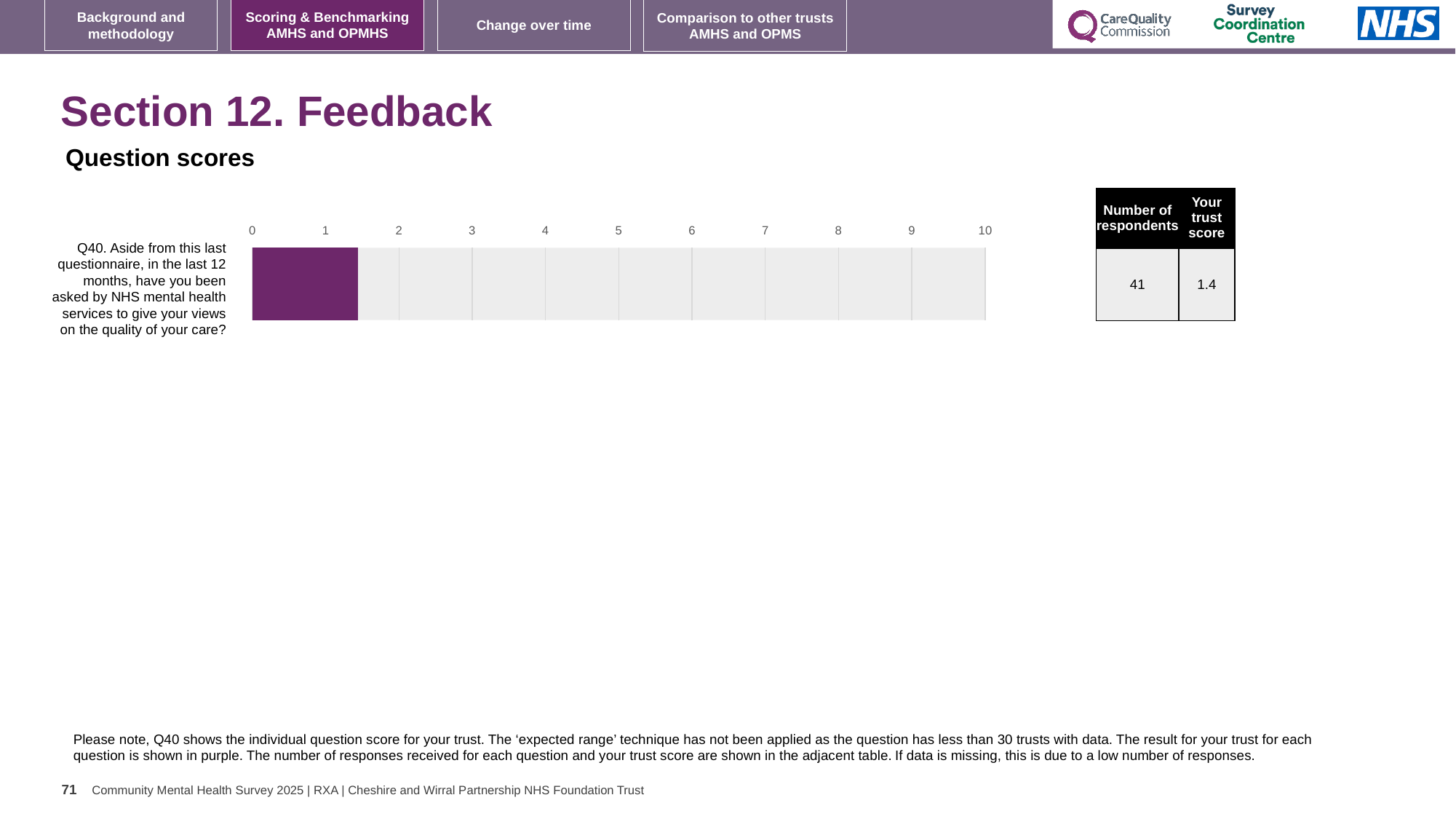
Is the bar for Q40 greater or less than 1 on the axis? greater How many questions (categories) are plotted in the chart? 1 How many respondents answered Q40 according to the table? 41 What is the maximum value shown on the chart's axis? 10 What colour is the bar representing the trust's score for Q40? purple Is the bar for Q40 greater or less than 2 on the axis? less What kind of chart is shown on the slide? bar chart What is the trust score for Q40 shown in the adjacent table? 1.4